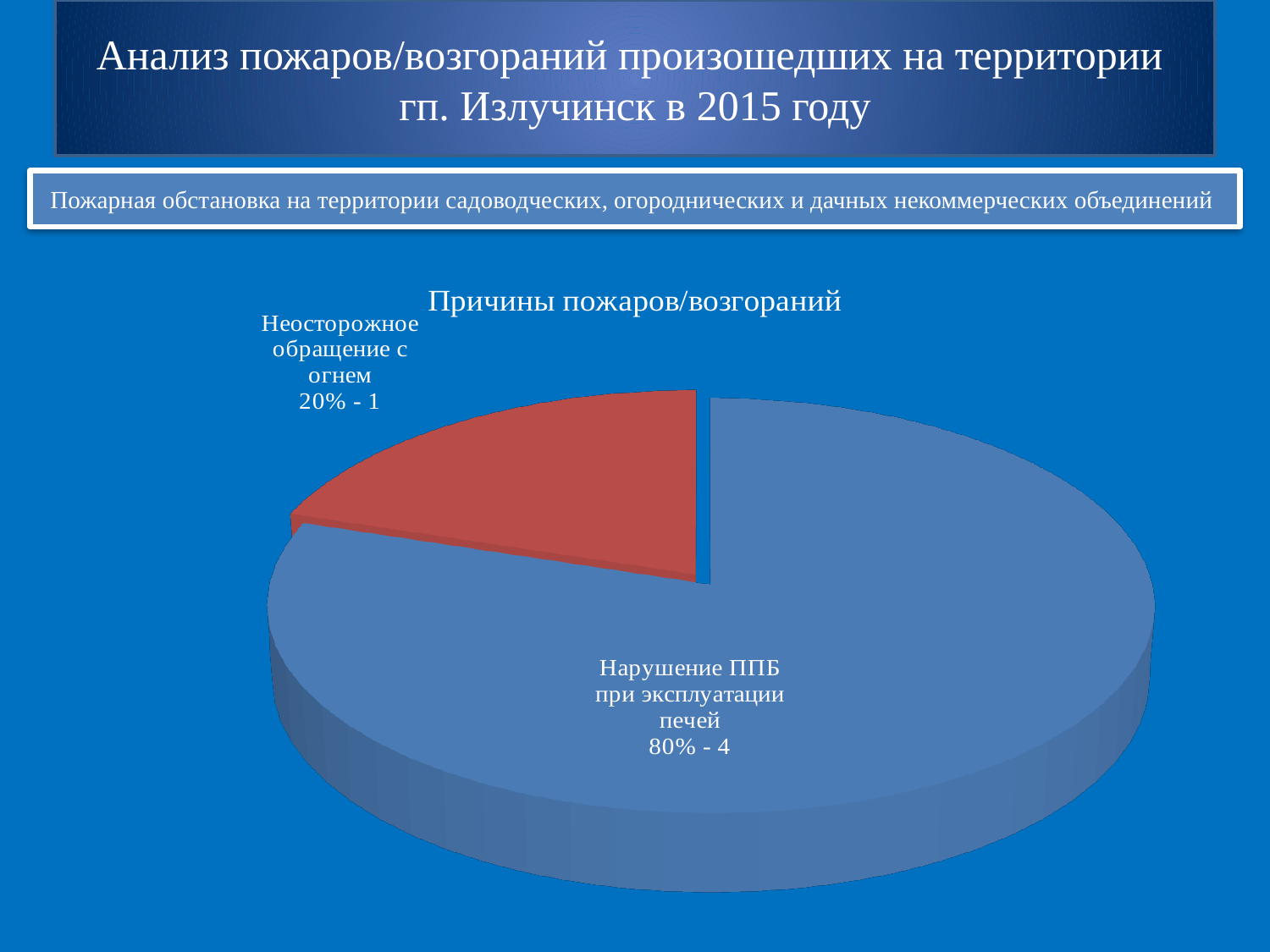
What is the title of the chart? Причины пожаров/возгораний Which cause accounts for the smallest share of fires? Неосторожное обращение с огнем What kind of chart is shown on the slide? pie chart What share of the pie does "Нарушение ППБ при эксплуатации печей" represent? 80% How many fires are attributed to "Нарушение ППБ при эксплуатации печей"? 4 Which is larger: the share for "Неосторожное обращение с огнем" or the share for "Нарушение ППБ при эксплуатации печей"? Нарушение ППБ при эксплуатации печей What colour is the slice for "Неосторожное обращение с огнем"? red Which cause accounts for the largest share of fires? Нарушение ППБ при эксплуатации печей What is the difference in the number of fires between "Нарушение ППБ при эксплуатации печей" and "Неосторожное обращение с огнем"? 3 What share of the pie does "Неосторожное обращение с огнем" represent? 20% How many slices does the pie chart have? 2 How many fires are attributed to "Неосторожное обращение с огнем"? 1